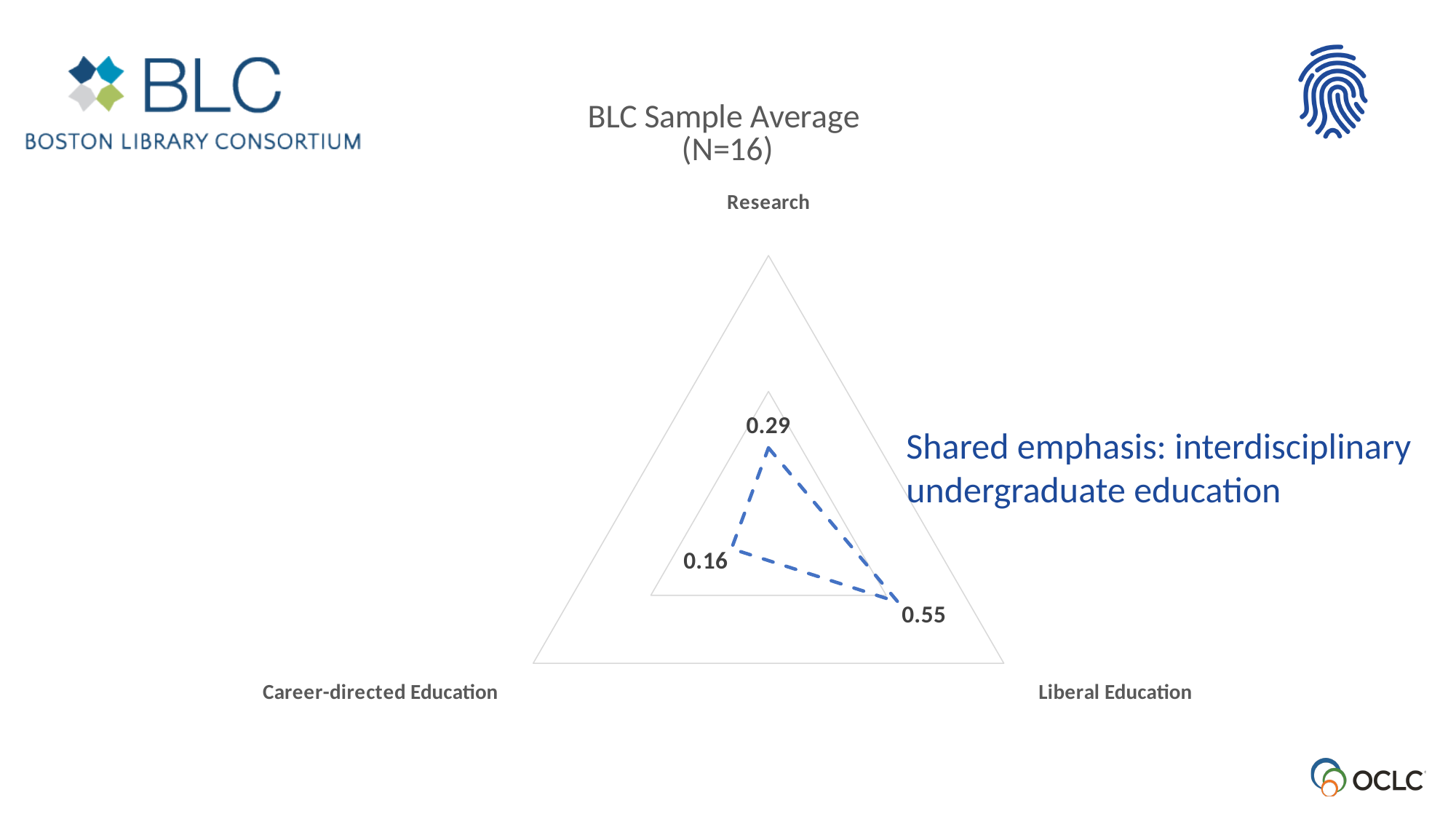
What kind of chart is shown on the slide? Radar chart What is the difference between the values for Research and Career-directed Education? 0.13 Which category has the lowest value? Career-directed Education Which is larger, the value for Research or the value for Career-directed Education? Research Which category has the highest value? Liberal Education What is the value for Liberal Education? 0.55 What is the total of the three plotted values? 1.00 What is the difference between the values for Liberal Education and Research? 0.26 What is the value for Career-directed Education? 0.16 What is the value for Research? 0.29 How many categories are plotted on the chart? 3 What is the title of the chart? BLC Sample Average (N=16)